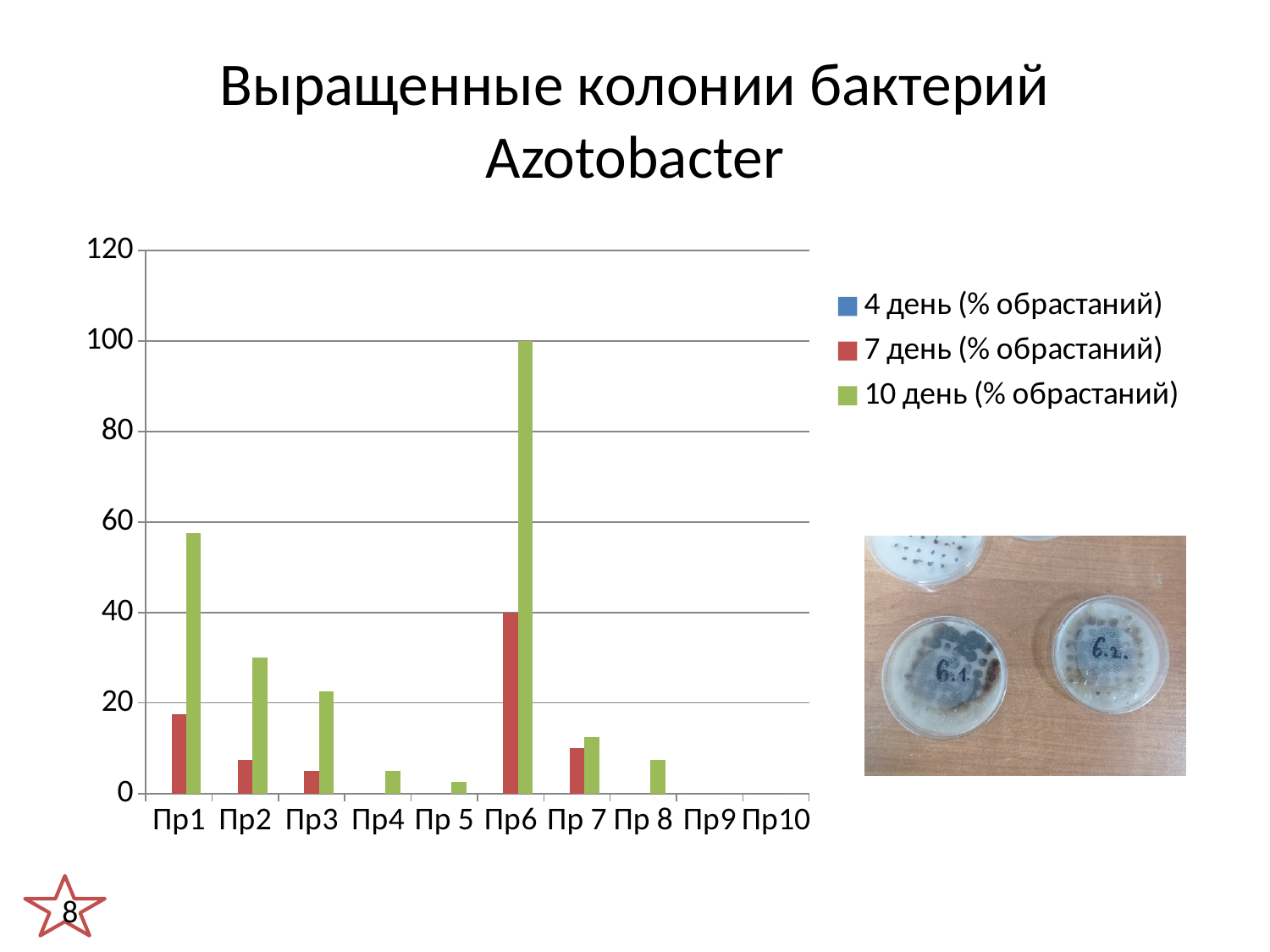
Is the value for Пр 7 in the series "10 день (% обрастаний)" greater or less than 20? less Which has the larger value for "7 день (% обрастаний)": Пр1 or Пр6? Пр6 What is the title of the slide containing the chart? Выращенные колонии бактерий Azotobacter How many series does the chart legend list? 3 Which category has the highest value for the series "10 день (% обрастаний)"? Пр6 What kind of chart is shown on the slide? bar chart What is the value for Пр6 in the series "10 день (% обрастаний)"? 100 Which has the larger value for "10 день (% обрастаний)": Пр1 or Пр2? Пр1 What is the value for Пр6 in the series "7 день (% обрастаний)"? 40 How many categories are shown along the x axis of the chart? 10 Is the value for Пр1 in the series "10 день (% обрастаний)" greater or less than 40? greater What colour represents the series "10 день (% обрастаний)" in the chart? green